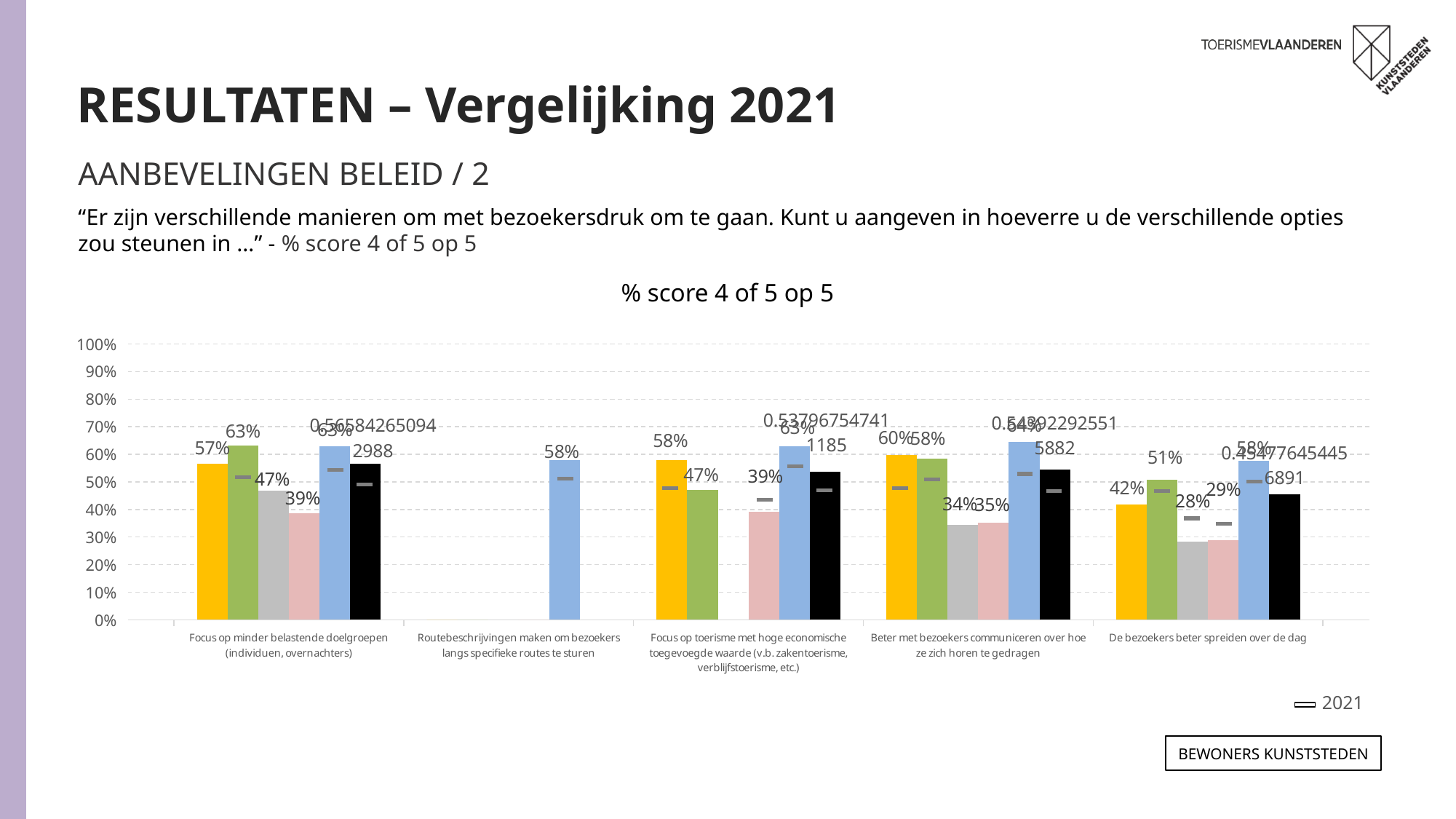
What is the value of the blue bar for 'Routebeschrijvingen maken om bezoekers langs specifieke routes te sturen'? 58% What is the value of the pink bar for 'De bezoekers beter spreiden over de dag'? 29% Which category has the highest value for the yellow bar? Beter met bezoekers communiceren over hoe ze zich horen te gedragen For 'De bezoekers beter spreiden over de dag', which is larger: the yellow bar or the green bar? The green bar What is the value of the grey bar for 'Beter met bezoekers communiceren over hoe ze zich horen te gedragen'? 34% How many categories are shown along the x axis of the chart? 5 What kind of chart is shown on the slide? Bar chart How many entries does the chart legend list? 1 What is the title of the chart? % score 4 of 5 op 5 What is the value of the yellow bar for 'Focus op minder belastende doelgroepen (individuen, overnachters)'? 57% Is the value of the black bar for 'De bezoekers beter spreiden over de dag' greater or less than 50%? less For 'De bezoekers beter spreiden over de dag', what is the difference between the green bar (51%) and the yellow bar (42%)? 9 percentage points